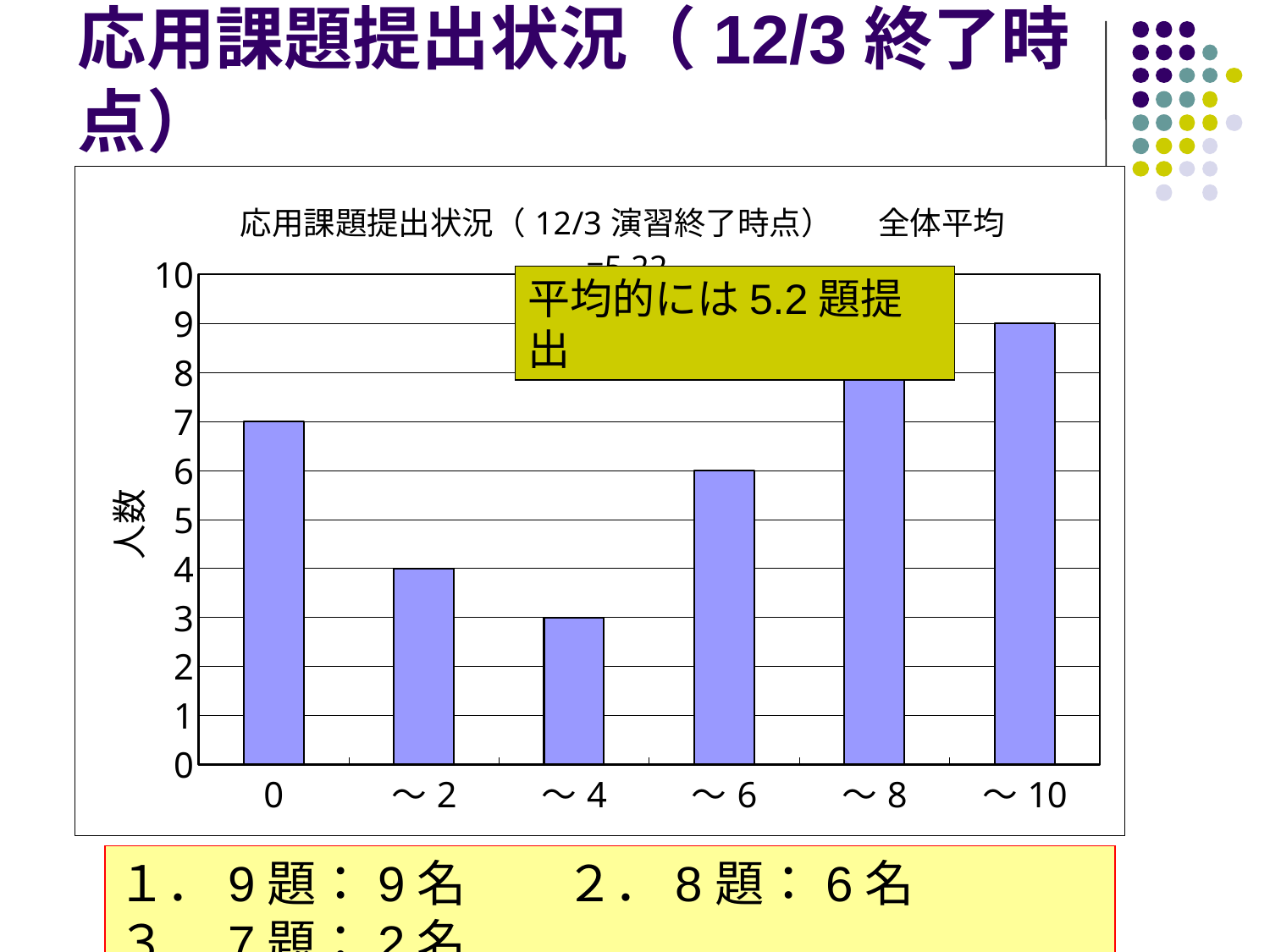
Which is larger, the value for ～2 or the value for ～6? ～6 What is the value (人数) for the category 0? 7 Which category has the highest value? ～10 How many categories are shown on the x axis? 6 What is the value (人数) for the category ～10? 9 What is the value (人数) for the category ～6? 6 What is the difference between the values for 0 and ～4? 4 Which category has the lowest value? ～4 What is the value (人数) for the category ～4? 3 Is the value for ～8 greater or less than 7? greater What is the value (人数) for the category ～2? 4 What kind of chart is shown on the slide? bar chart